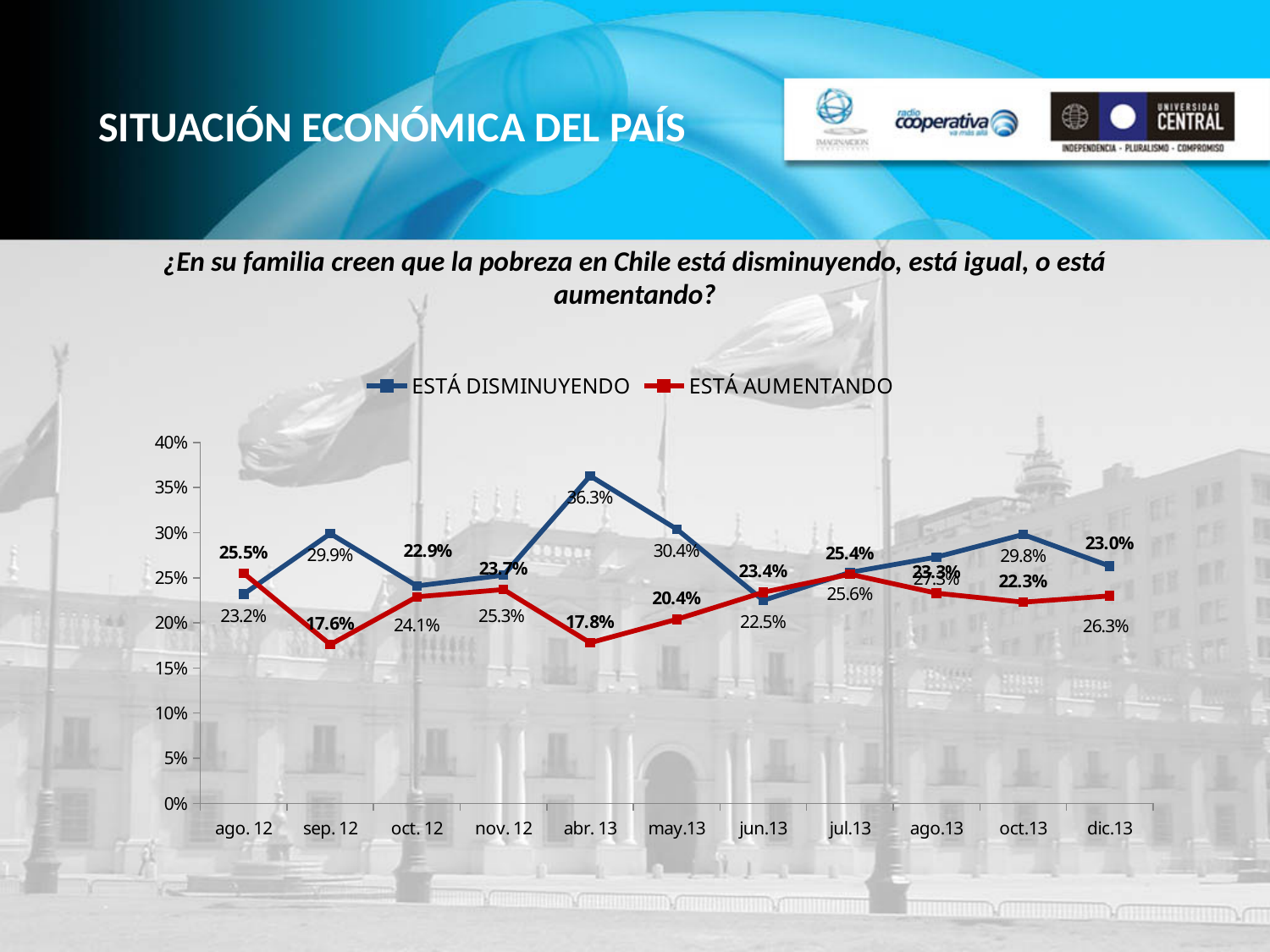
In which month does ESTÁ AUMENTANDO reach its lowest value? sep. 12 Does ESTÁ DISMINUYENDO rise or fall from abr. 13 to jun.13? Fall What type of chart is shown on the slide? Line chart In which month does ESTÁ DISMINUYENDO reach its highest value? abr. 13 What is the difference between ESTÁ DISMINUYENDO and ESTÁ AUMENTANDO in abr. 13? 18.5 percentage points Is the value for ESTÁ DISMINUYENDO in abr. 13 greater or less than 35%? greater What is the value of ESTÁ AUMENTANDO in dic.13? 23.0% How many time points are plotted along the x axis? 11 What is the value of ESTÁ DISMINUYENDO in abr. 13? 36.3% What is the value of ESTÁ AUMENTANDO in sep. 12? 17.6% In ago. 12, which series has the higher value, ESTÁ DISMINUYENDO or ESTÁ AUMENTANDO? ESTÁ AUMENTANDO How many series does the legend list? 2